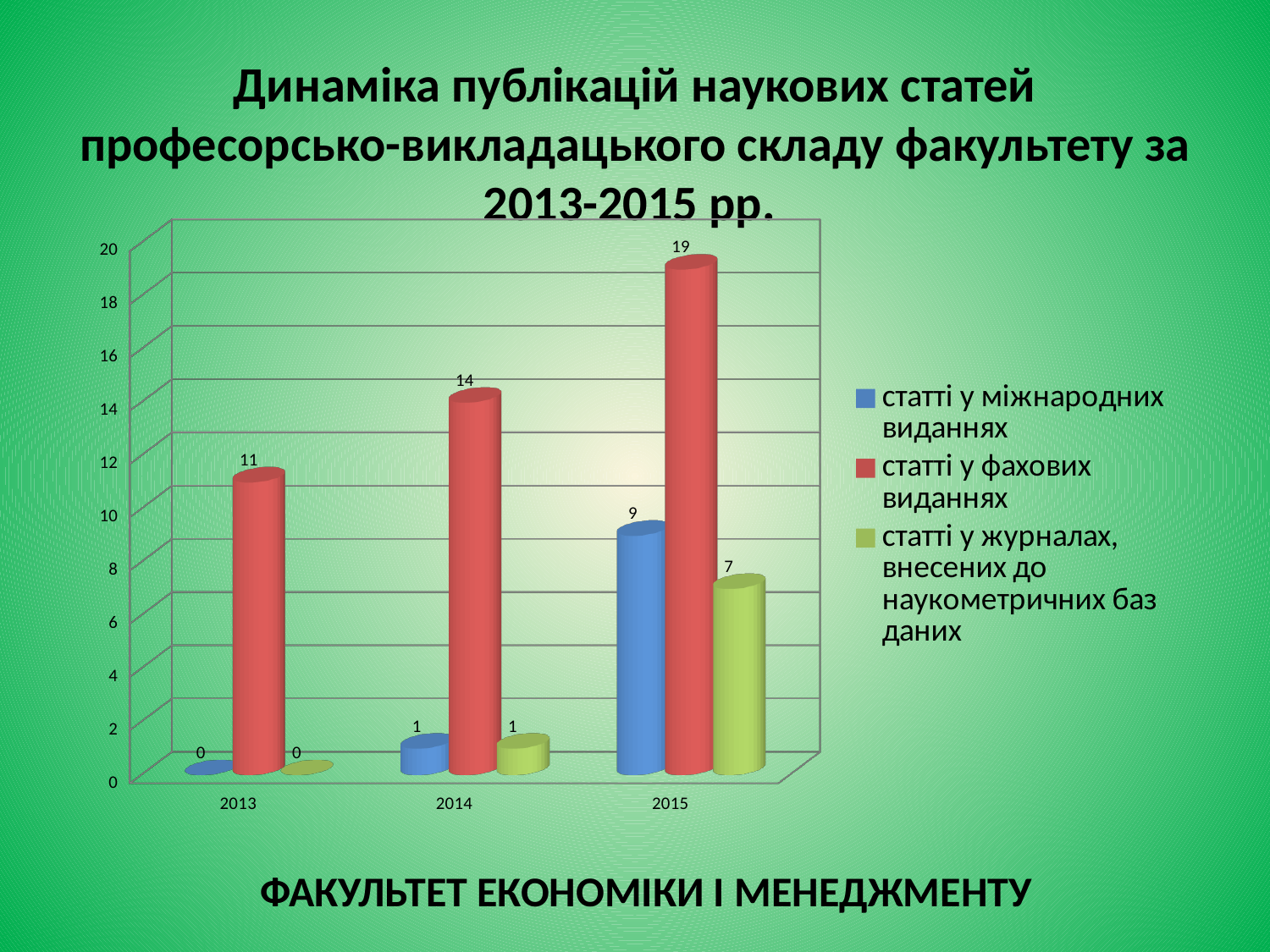
Which is larger in 2015: 'статті у міжнародних виданнях' or 'статті у журналах, внесених до наукометричних баз даних'? статті у міжнародних виданнях What is the value for 'статті у фахових виданнях' in 2015? 19 What is the value for 'статті у журналах, внесених до наукометричних баз даних' in 2015? 7 In which year is the value for 'статті у фахових виданнях' lowest? 2013 How many years are shown on the x axis? 3 What type of chart is shown on the slide? bar chart What is the value for 'статті у міжнародних виданнях' in 2014? 1 In which year is the value for 'статті у фахових виданнях' highest? 2015 What is the difference between the 'статті у фахових виданнях' values for 2015 and 2013? 8 Do the values for 'статті у фахових виданнях' rise or fall from 2013 to 2015? rise What colour are the bars for 'статті у фахових виданнях'? red How many series does the legend list? 3